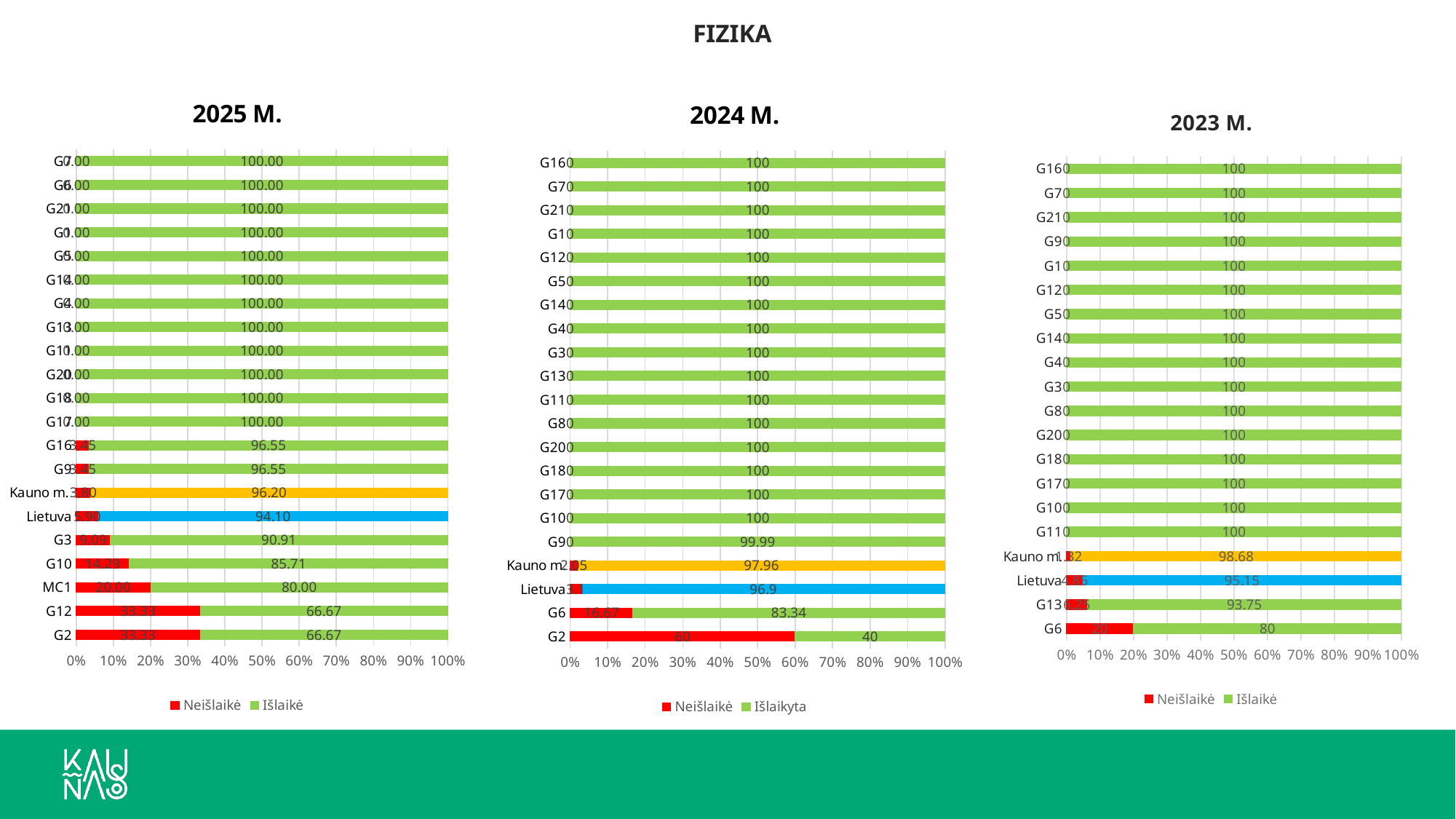
In the 2024 M. chart, which category has the lowest Išlaikyta value? G2 In the 2025 M. chart, what is the Išlaikė value for G10? 85.71 In the 2025 M. chart, what is the difference between the Išlaikė values for Kauno m. and Lietuva? 2.10 What kind of chart is the 2025 M. chart? Stacked bar chart How many series does the legend of the 2024 M. chart list? 2 How many categories are shown in the 2023 M. chart? 20 In the 2024 M. chart, what is the Neišlaikė value for G2? 60 In the 2025 M. chart, what is the total of the stacked bar for G12? 100.00 In the 2025 M. chart, what is the Neišlaikė value for MC1? 20.00 In the 2024 M. chart, which is larger: the Išlaikyta value for G6 or for Lietuva? Lietuva In the 2023 M. chart, which category has the highest Neišlaikė value? G6 In the 2023 M. chart, what is the Išlaikė value for G13? 93.75